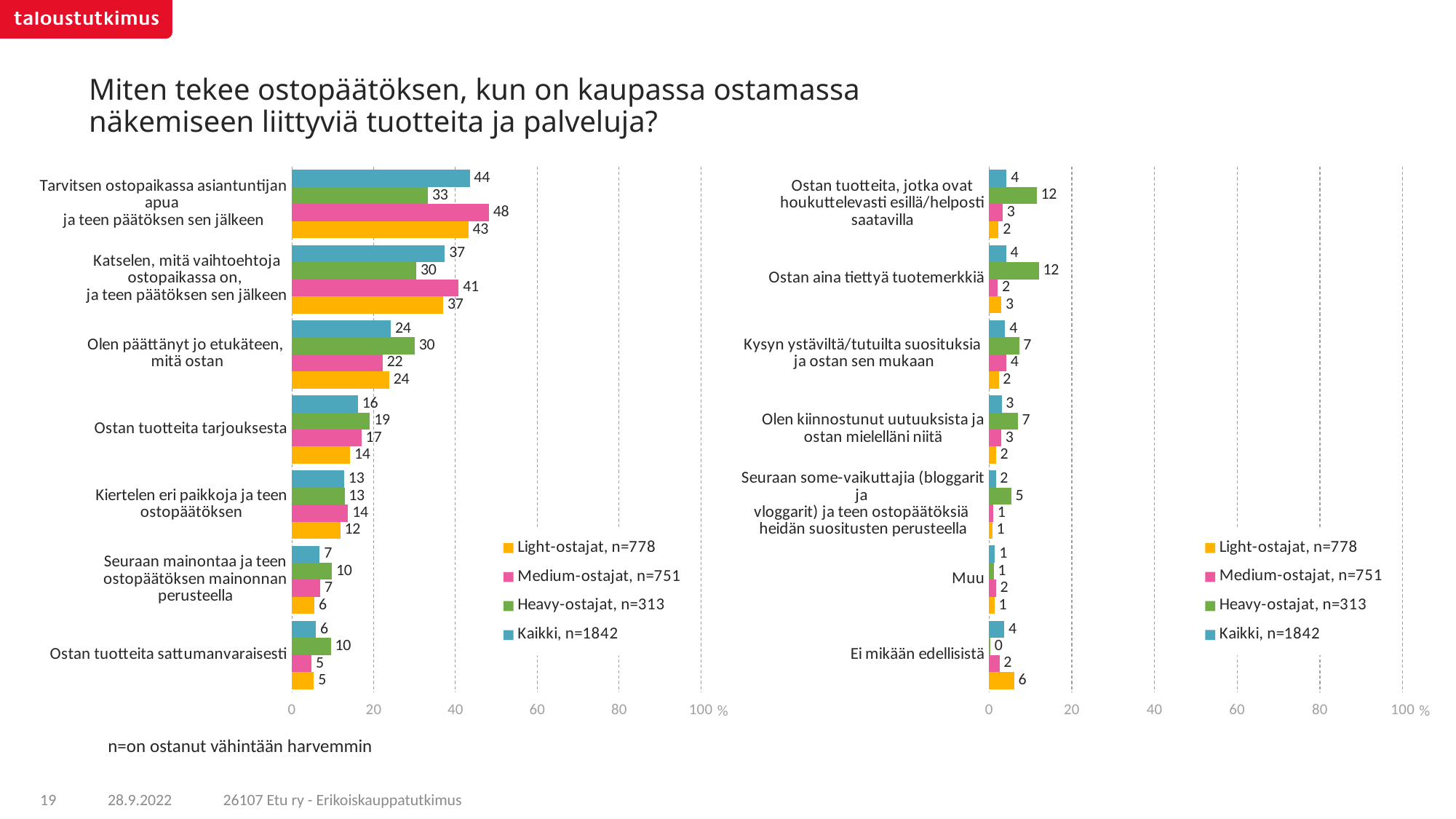
In the right chart, which category has the lowest value for Heavy-ostajat? Ei mikään edellisistä In the left chart, is the value for Medium-ostajat for "Tarvitsen ostopaikassa asiantuntijan apua ja teen päätöksen sen jälkeen" greater or less than 40? greater In the left chart, what is the value for Kaikki for "Olen päättänyt jo etukäteen, mitä ostan"? 24 In the right chart, what is the value for Light-ostajat for "Ei mikään edellisistä"? 6 In the left chart, which category has the highest value for Kaikki? Tarvitsen ostopaikassa asiantuntijan apua ja teen päätöksen sen jälkeen How many series does the legend of the left chart list? 4 In the left chart, what is the value for Medium-ostajat for "Tarvitsen ostopaikassa asiantuntijan apua ja teen päätöksen sen jälkeen"? 48 What kind of chart is the left chart? Bar chart In the right chart, what is the value for Heavy-ostajat for "Ostan aina tiettyä tuotemerkkiä"? 12 In the left chart, what is the difference between Medium-ostajat and Heavy-ostajat for "Katselen, mitä vaihtoehtoja ostopaikassa on, ja teen päätöksen sen jälkeen"? 11 In the left chart, for "Ostan tuotteita sattumanvaraisesti", which is larger: Heavy-ostajat or Kaikki? Heavy-ostajat How many categories does the right chart show? 7